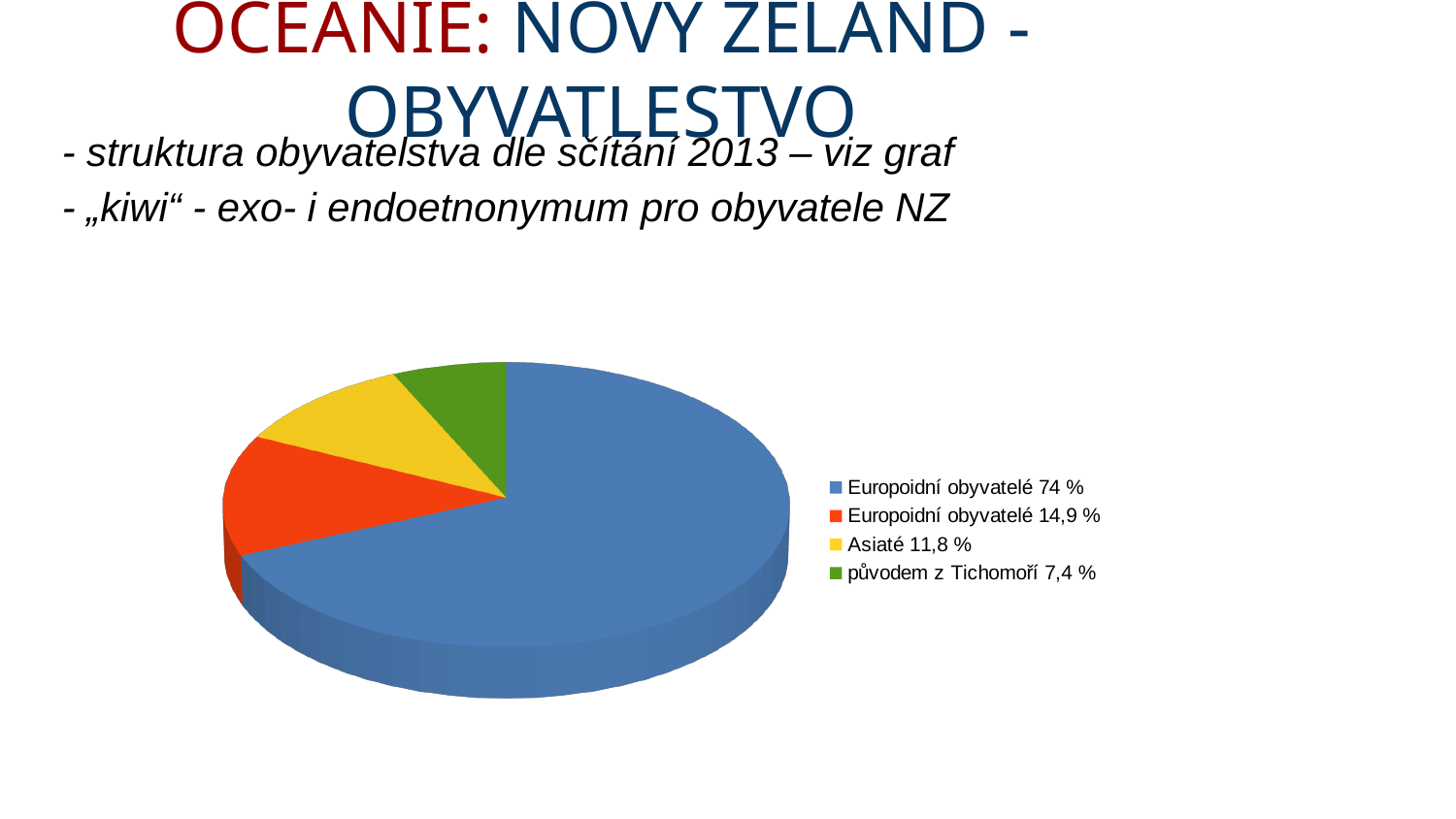
How many slices does the pie chart have? 4 Which legend entry has the smallest share of the pie? původem z Tichomoří 7,4 % What percentage is shown in the legend for Asiaté? 11,8 % What is the difference between the share for Asiaté and the share for původem z Tichomoří? 4,4 % What percentage is shown in the legend for původem z Tichomoří? 7,4 % Which is larger: the share for Asiaté or the share for původem z Tichomoří? Asiaté What percentage is shown for the second legend entry, Europoidní obyvatelé (orange slice)? 14,9 % Which legend entry has the largest share of the pie? Europoidní obyvatelé 74 % What kind of chart is shown on the slide? pie chart What percentage is shown for the first legend entry, Europoidní obyvatelé (blue slice)? 74 % How many entries does the legend of the pie chart list? 4 What colour is the slice for původem z Tichomoří in the pie chart? green